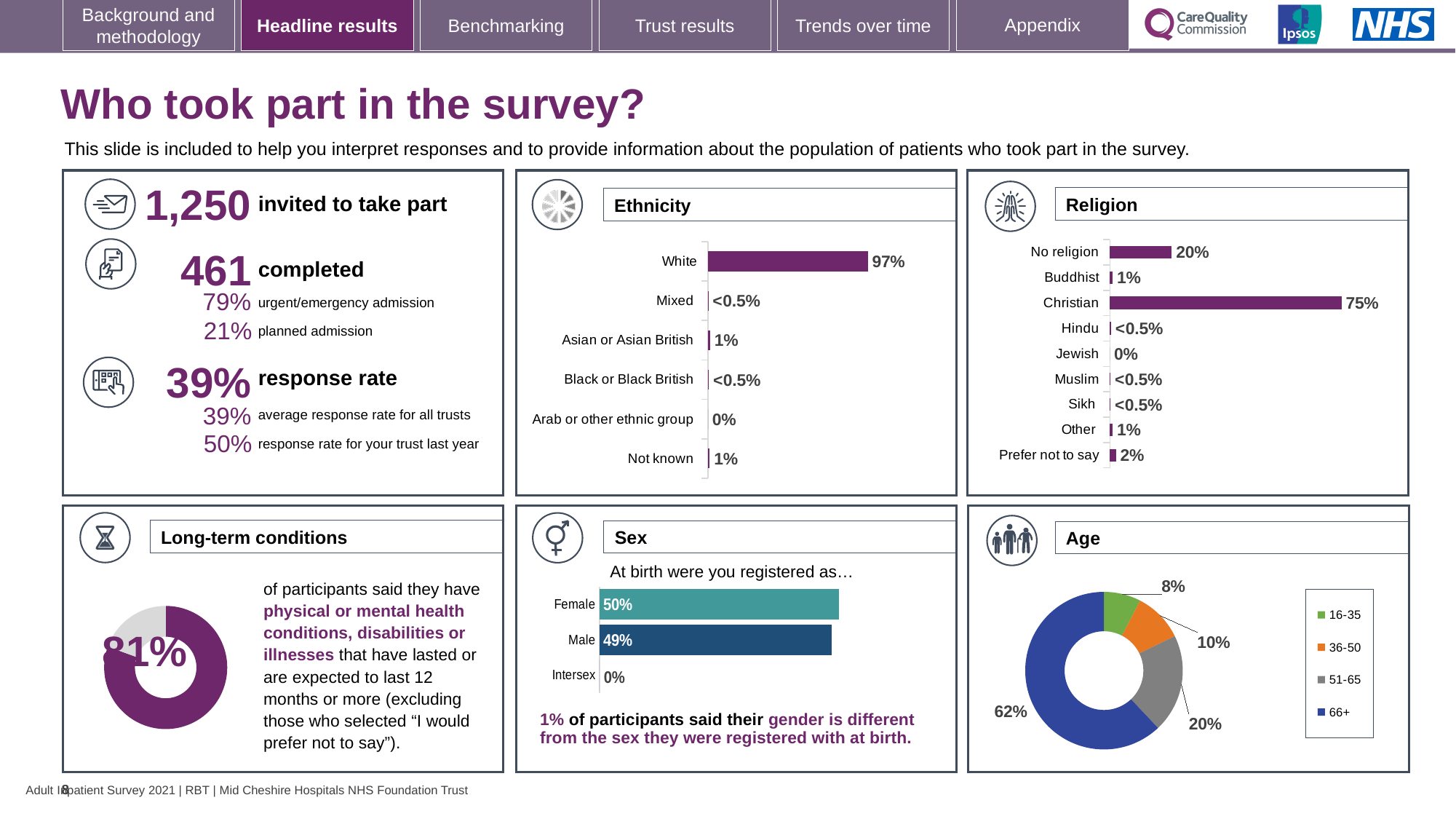
How many age groups does the legend of the Age chart list? 4 How many categories are shown in the Religion chart? 9 In the Religion chart, what percentage of participants were Christian? 75% In the Sex chart, which is larger, the Female value or the Male value? Female How many categories are shown in the Ethnicity chart? 6 What kind of chart is the Religion chart? Bar chart In the Sex chart, what percentage of participants were registered as Male at birth? 49% In the Ethnicity chart, what percentage of participants were White? 97% In the Age chart, which age group has the smallest share? 16-35 In the Ethnicity chart, which category has the highest value? White In the Age chart, what share of participants were aged 66+? 62% In the Religion chart, what is the difference between the Christian and No religion values? 55%